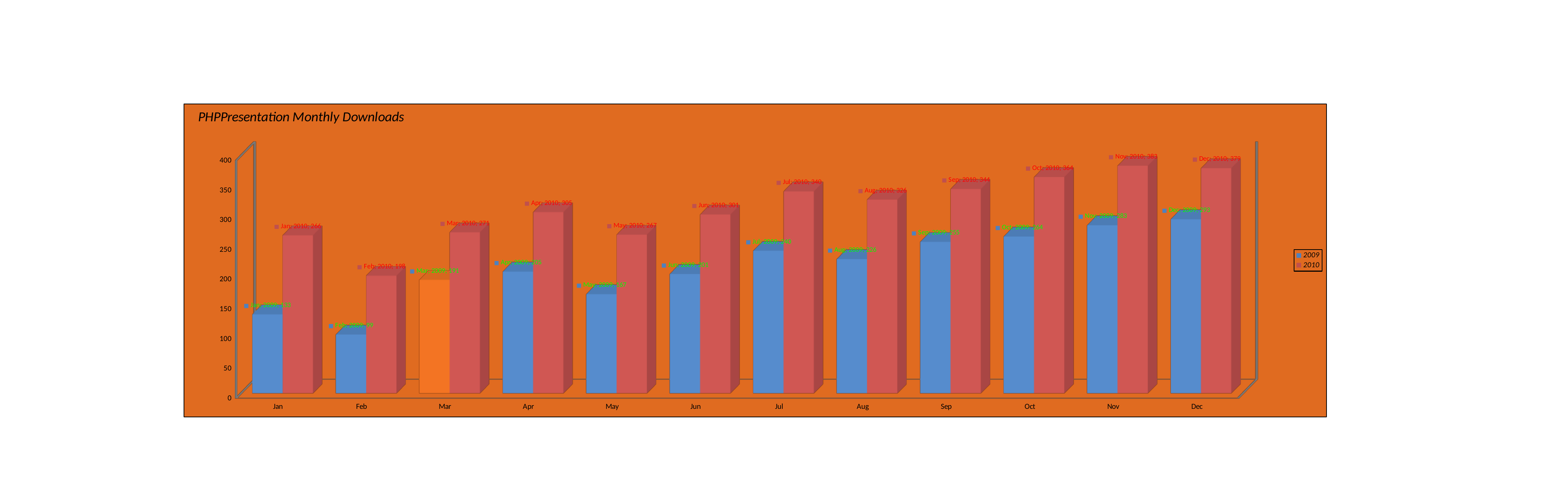
How many series does the legend list? 2 What is the value for Jan 2010? 266 Which month has the lowest value for 2010? Feb Is the value for Jul 2010 greater or less than 300? greater What kind of chart is shown on the slide? bar chart How many months are shown on the x axis? 12 Which is larger, the 2010 value for Apr or the 2010 value for May? Apr What is the value for Jan 2009? 133 What is the value for Nov 2010? 383 What is the title of the chart? PHPPresentation Monthly Downloads Which month has the highest value for 2010? Nov What is the difference between the 2010 values for Nov and Jan? 117